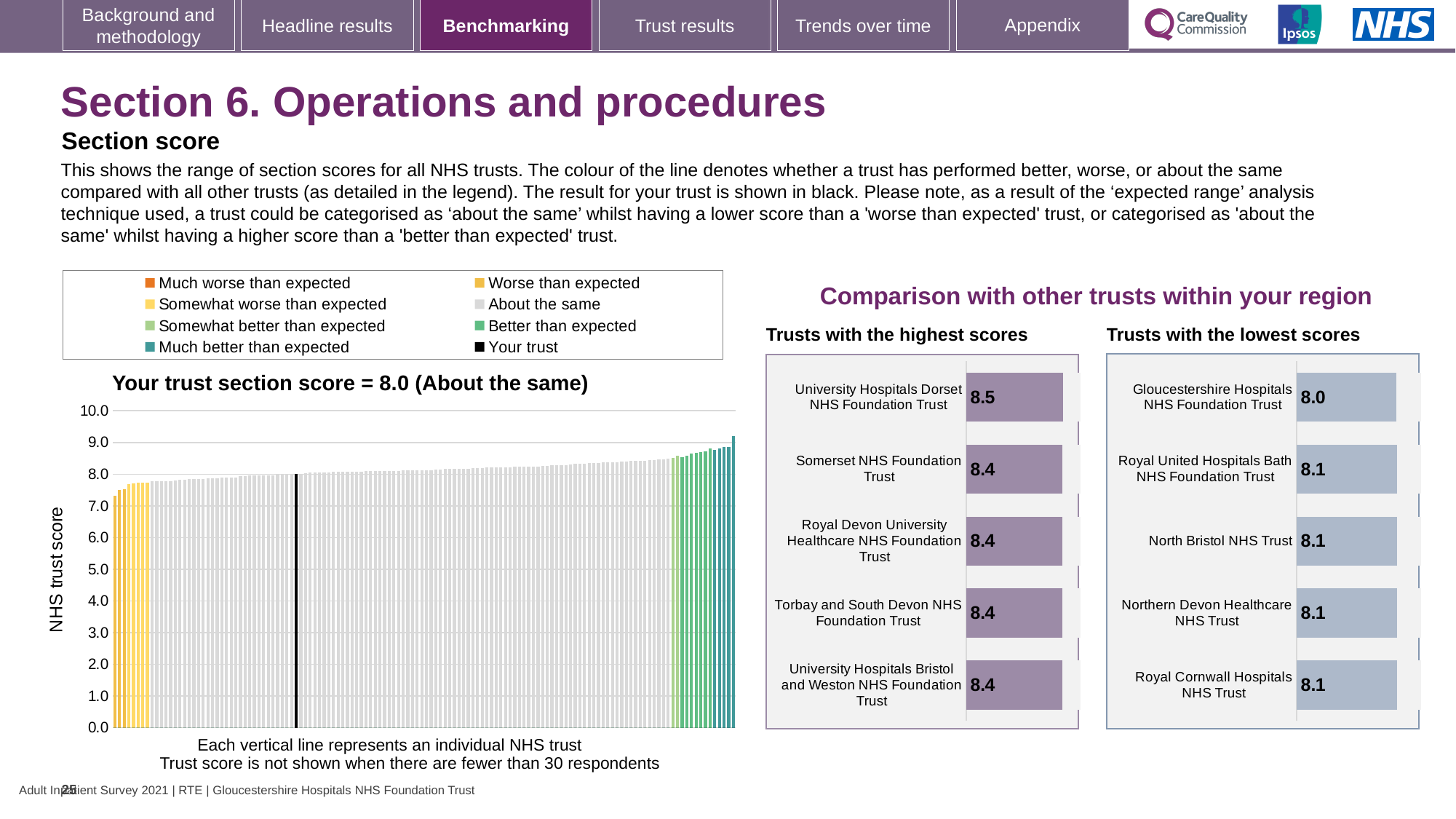
In the 'Trusts with the highest scores' chart, which trust has the highest score? University Hospitals Dorset NHS Foundation Trust In the 'Trusts with the lowest scores' chart, what is the score for Gloucestershire Hospitals NHS Foundation Trust? 8.0 In the 'Trusts with the lowest scores' chart, which is larger: the score for Royal United Hospitals Bath NHS Foundation Trust or Gloucestershire Hospitals NHS Foundation Trust? Royal United Hospitals Bath NHS Foundation Trust How many entries does the legend above the 'Your trust section score' chart list? 8 In the 'Trusts with the lowest scores' chart, what is the score for Royal Cornwall Hospitals NHS Trust? 8.1 In the 'Trusts with the highest scores' chart, how many trusts are listed? 5 In the 'Trusts with the highest scores' chart, what is the score for Somerset NHS Foundation Trust? 8.4 In the 'Trusts with the lowest scores' chart, which trust has the lowest score? Gloucestershire Hospitals NHS Foundation Trust What kind of chart is the 'Your trust section score' chart on the left? Bar chart In the 'Trusts with the highest scores' chart, what is the score for University Hospitals Dorset NHS Foundation Trust? 8.5 In the 'Your trust section score' chart on the left, do the trust scores rise or fall from left to right along the x axis? Rise In the 'Trusts with the highest scores' chart, what is the difference between the scores of University Hospitals Dorset NHS Foundation Trust and Torbay and South Devon NHS Foundation Trust? 0.1